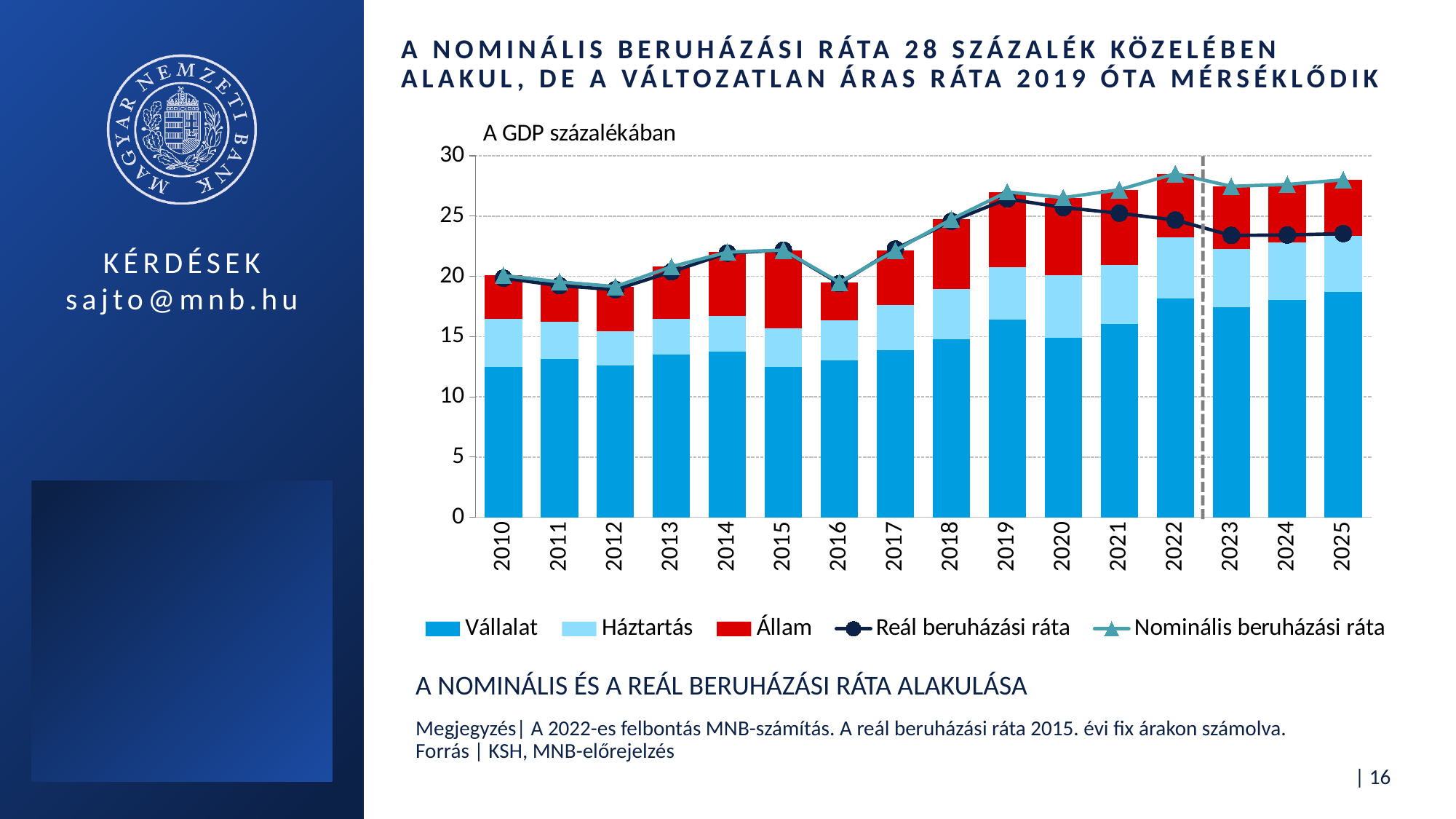
What unit label is shown above the chart's y axis? A GDP százalékában In which year does the Nominális beruházási ráta line reach its highest value? 2022 Is the value of the Nominális beruházási ráta in 2022 greater or less than 25? greater Which colour represents the Állam series in the chart? Red Which is larger: the Nominális beruházási ráta in 2022 or in 2016? 2022 Is the value of the Reál beruházási ráta in 2012 greater or less than 20? less How many years are shown on the x axis of the chart? 16 Is the Vállalat segment in 2025 greater or less than 15? greater In which year does the Reál beruházási ráta line reach its highest value? 2019 Does the Reál beruházási ráta line rise or fall between 2019 and 2023? It falls What kind of chart is shown on the slide? A combined stacked bar and line chart How many series does the chart legend list? 5